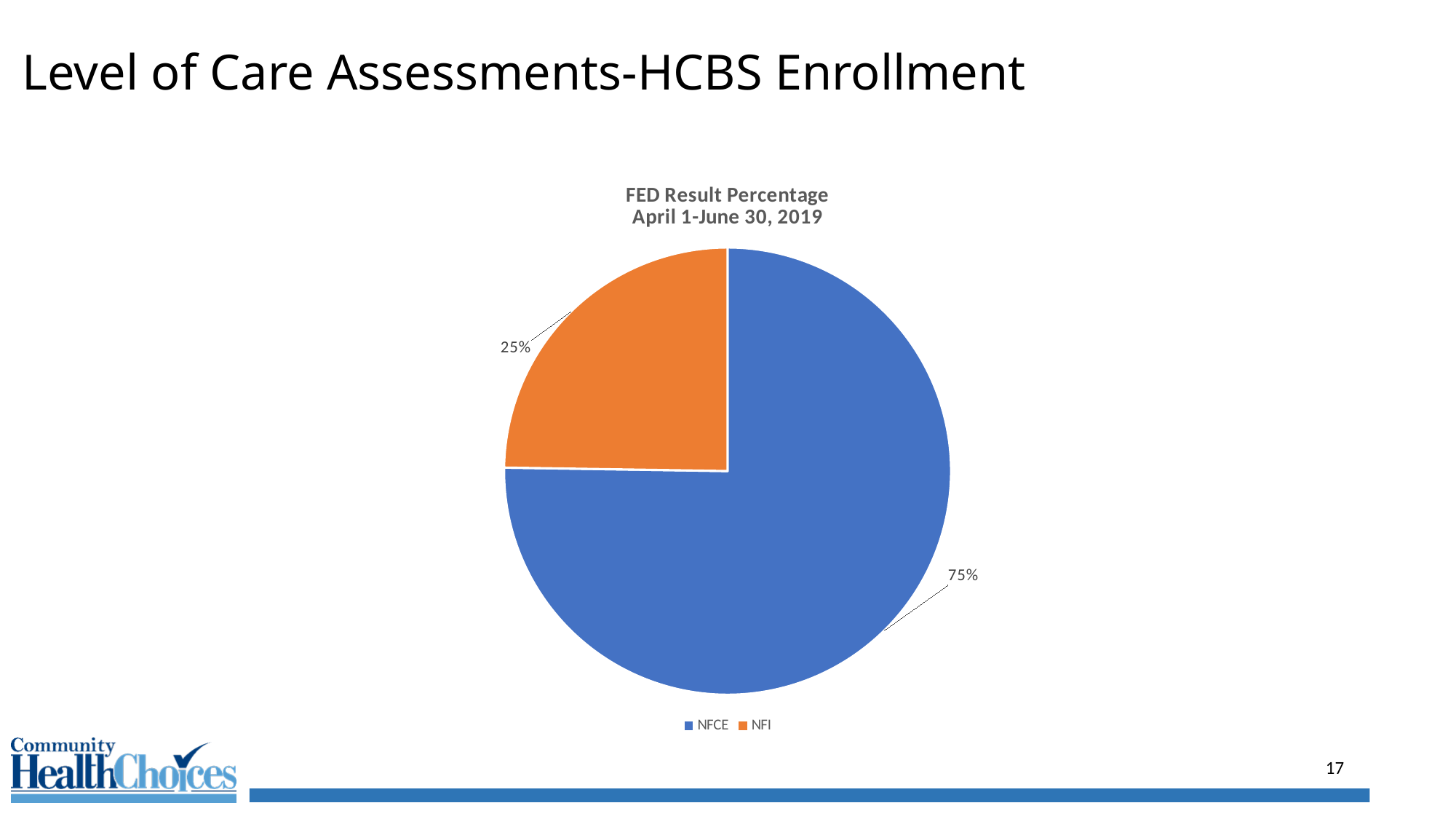
What percentage of the pie does NFCE represent? 75% What type of chart is shown on the slide? pie chart How many entries does the legend list? 2 What percentage of the pie does NFI represent? 25% Which category has the smallest share of the pie? NFI What is the difference in percentage points between NFCE and NFI? 50 Which category has the largest share of the pie? NFCE How many slices does the pie chart have? 2 Which is larger, the NFCE share or the NFI share? NFCE What is the title of the chart? FED Result Percentage April 1-June 30, 2019 What colour is the NFI slice? orange What is the share of the pie taken by the blue slice? 75%